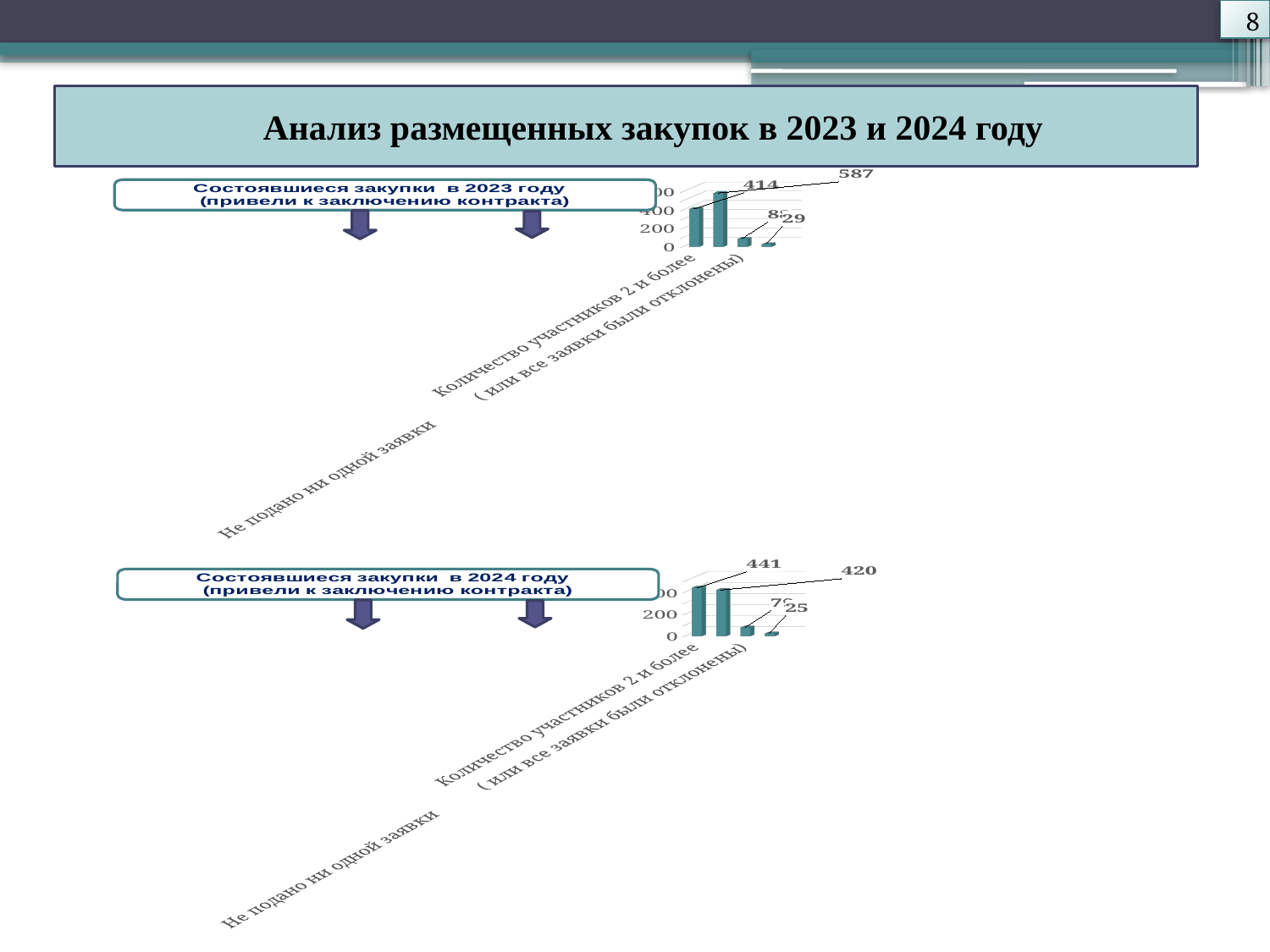
What type of chart is used on the top of the slide for 2023? Bar chart On the bottom chart (2024), which is larger: the first bar (441) or the second bar (420)? 441 On the top chart (2023), what is the highest data label shown? 587 On the bottom chart (2024), what is the highest data label shown? 441 How many bars are plotted on the bottom chart (2024)? 4 On the top chart (2023), what is the lowest data label shown? 29 On the bottom chart (2024), what is the value of the second bar from the left? 420 On the bottom chart (2024), what is the difference between the two largest values, 441 and 420? 21 On the bottom chart (2024), what is the lowest data label shown? 25 On the top chart (2023), which is larger: the first bar (414) or the second bar (587)? 587 On the top chart (2023), what is the value of the first (leftmost) bar? 414 On the top chart (2023), what is the difference between the two largest values, 587 and 414? 173